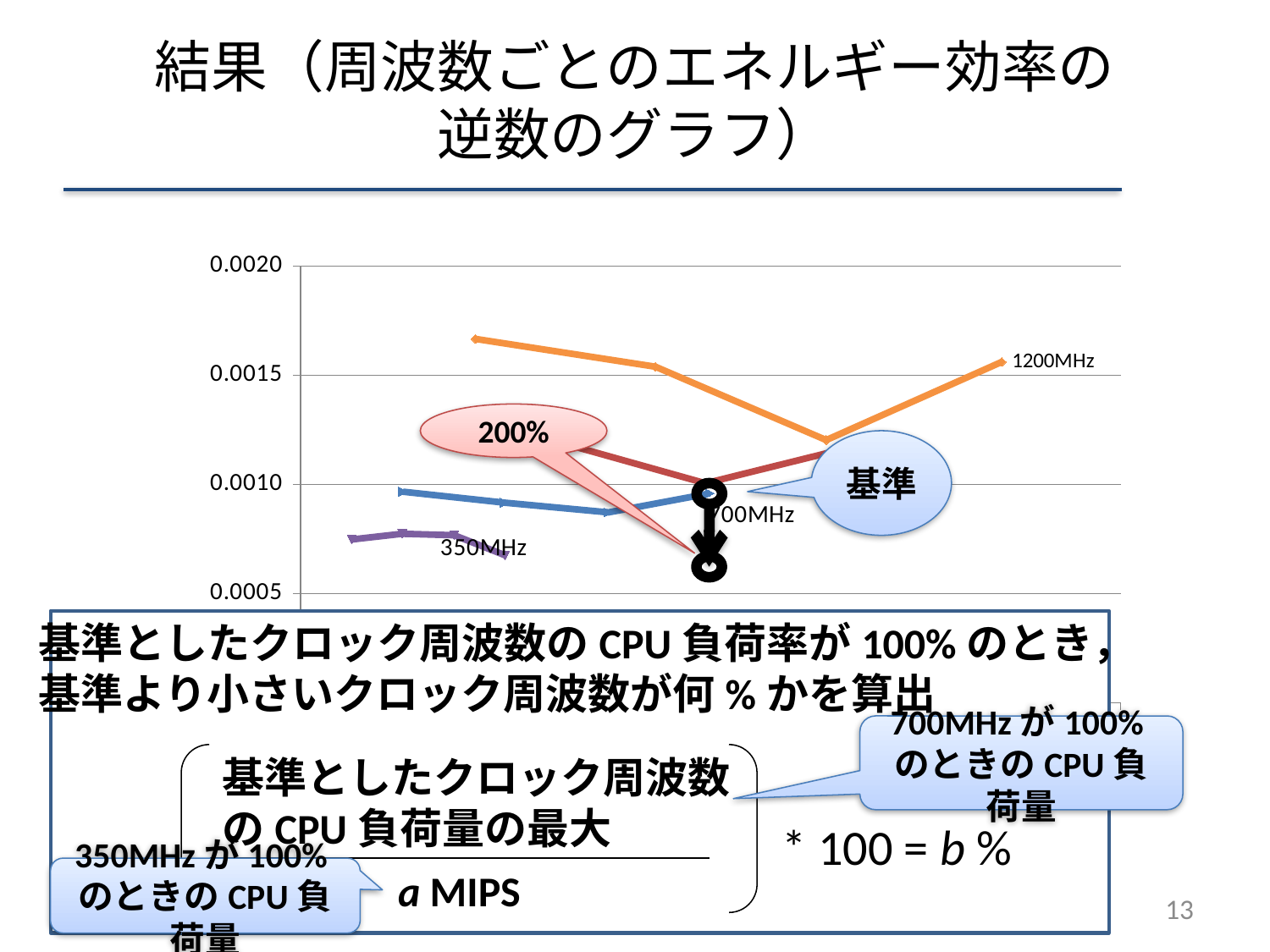
Does the 1200MHz line fall or rise from its first point to its third point? fall Which line has lower values, 350MHz or 700MHz? 350MHz Is the leftmost point of the 1200MHz line greater or less than 0.0015? greater Which labelled line lies highest on the chart? 1200MHz Is the lowest point of the 1200MHz line greater or less than 0.0010? greater What is the highest tick value shown on the y axis? 0.0020 Which line has higher values, 1200MHz or 700MHz? 1200MHz What kind of chart is shown on the slide? line chart What is the lowest tick value shown on the y axis? 0.0005 Which labelled line lies lowest on the chart? 350MHz How many lines are plotted on the chart? 4 Are the values of the 350MHz line greater or less than 0.0010? less